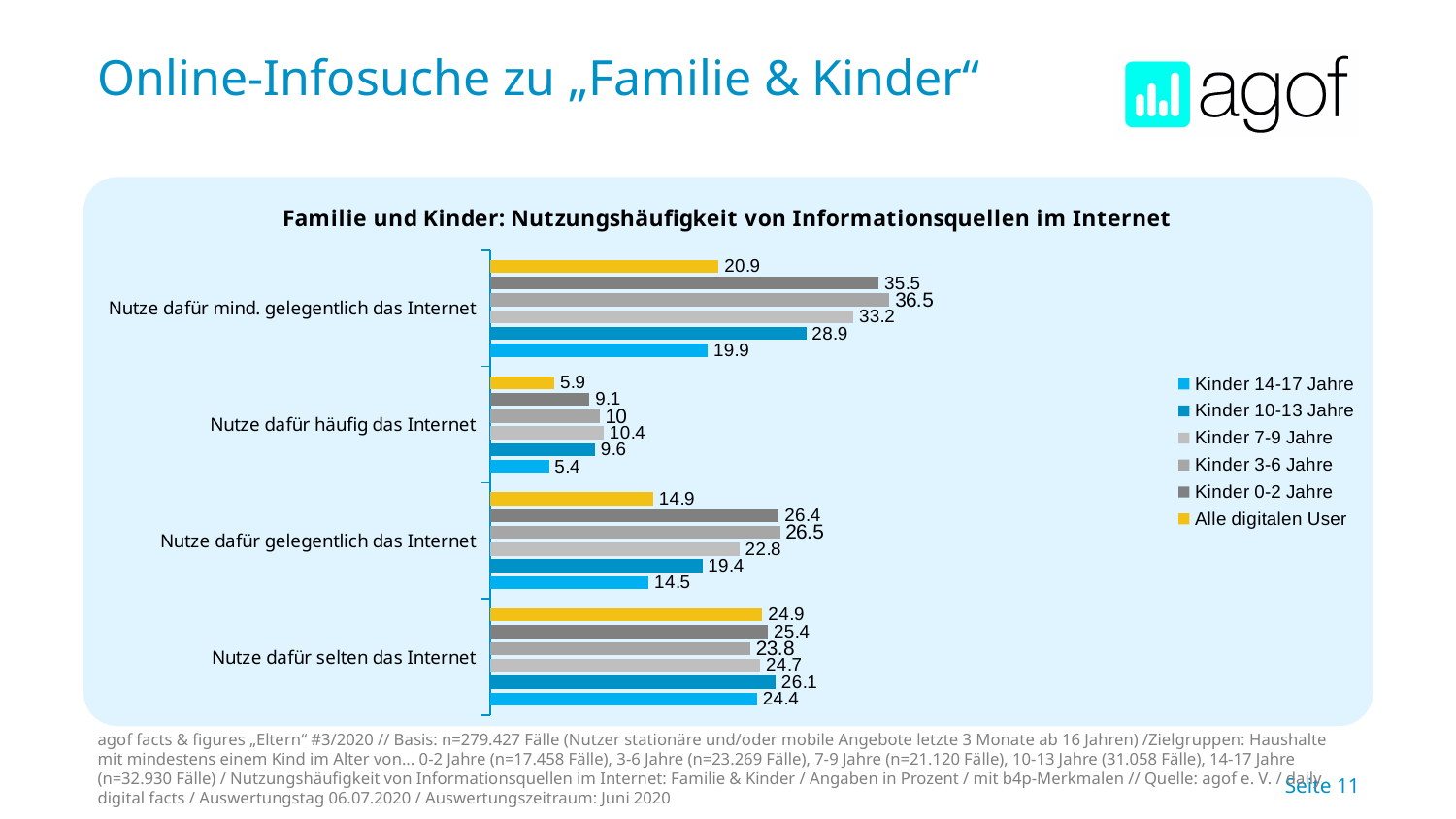
Which series has the lowest value in the category "Nutze dafür häufig das Internet"? Kinder 14-17 Jahre What is the value for Kinder 14-17 Jahre in the category "Nutze dafür selten das Internet"? 24.4 In the category "Nutze dafür mind. gelegentlich das Internet", which is larger: Kinder 7-9 Jahre or Kinder 10-13 Jahre? Kinder 7-9 Jahre What is the value for Kinder 3-6 Jahre in the category "Nutze dafür mind. gelegentlich das Internet"? 36.5 What is the title of the chart? Familie und Kinder: Nutzungshäufigkeit von Informationsquellen im Internet How many series does the legend list? 6 What is the value for Alle digitalen User in the category "Nutze dafür häufig das Internet"? 5.9 How many categories are shown on the vertical axis? 4 Which series has the highest value in the category "Nutze dafür mind. gelegentlich das Internet"? Kinder 3-6 Jahre What is the value for Kinder 10-13 Jahre in the category "Nutze dafür gelegentlich das Internet"? 19.4 What is the difference between Kinder 0-2 Jahre and Alle digitalen User in the category "Nutze dafür gelegentlich das Internet"? 11.5 What kind of chart is shown on the slide? bar chart